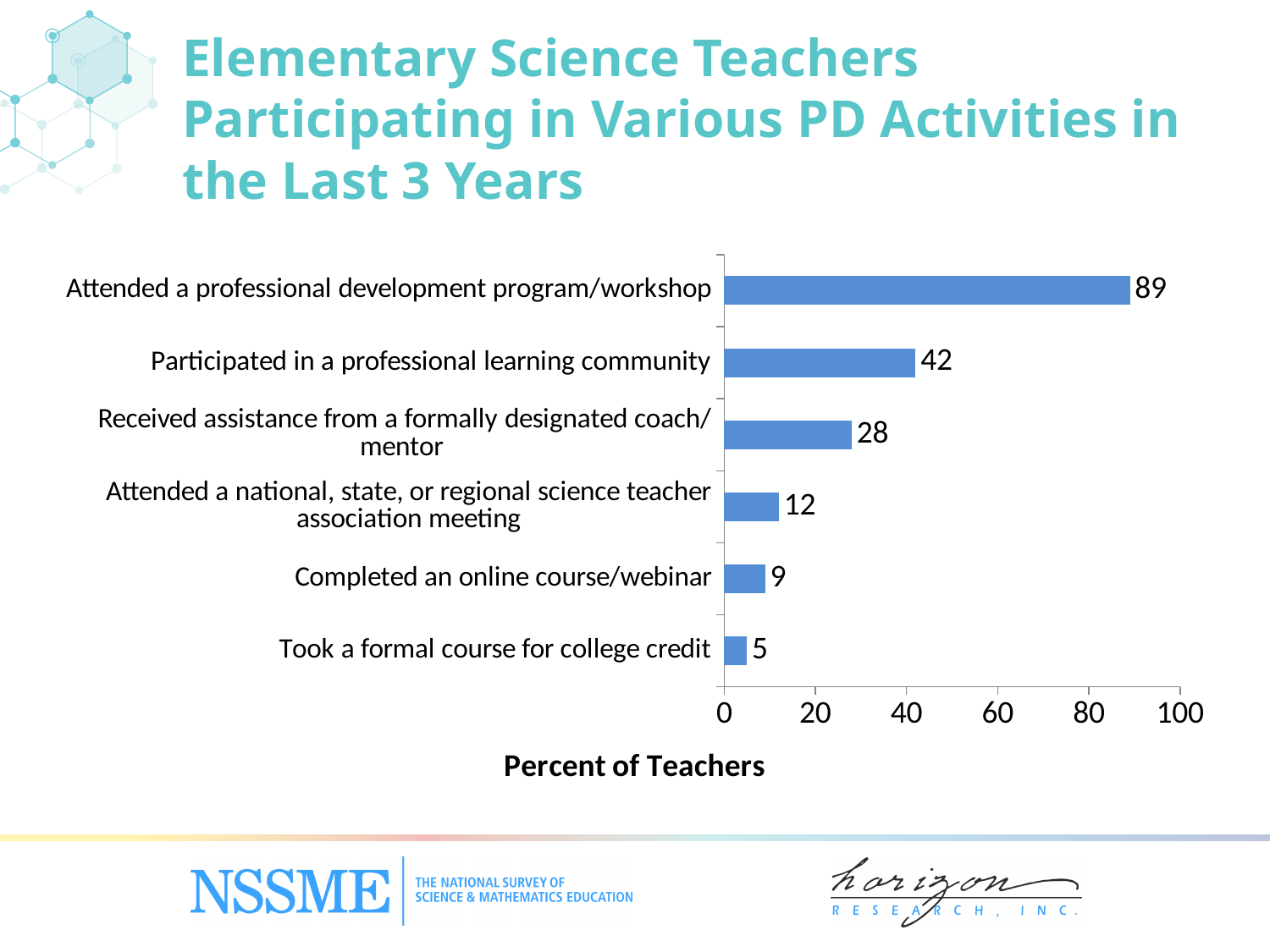
What kind of chart is shown on the slide? Bar chart What percent of teachers completed an online course/webinar? 9 How many PD activities are shown in the chart? 6 What percent of teachers attended a professional development program/workshop? 89 Which PD activity has the lowest percent of teachers? Took a formal course for college credit What percent of teachers received assistance from a formally designated coach/mentor? 28 Which is larger: the percent of teachers who attended a national, state, or regional science teacher association meeting or the percent who completed an online course/webinar? Attended a national, state, or regional science teacher association meeting Which PD activity has the highest percent of teachers? Attended a professional development program/workshop Is the value for 'Received assistance from a formally designated coach/mentor' greater or less than 40? less What is the label of the horizontal axis? Percent of Teachers What is the difference in percent of teachers between attending a professional development program/workshop and participating in a professional learning community? 47 What percent of teachers participated in a professional learning community? 42